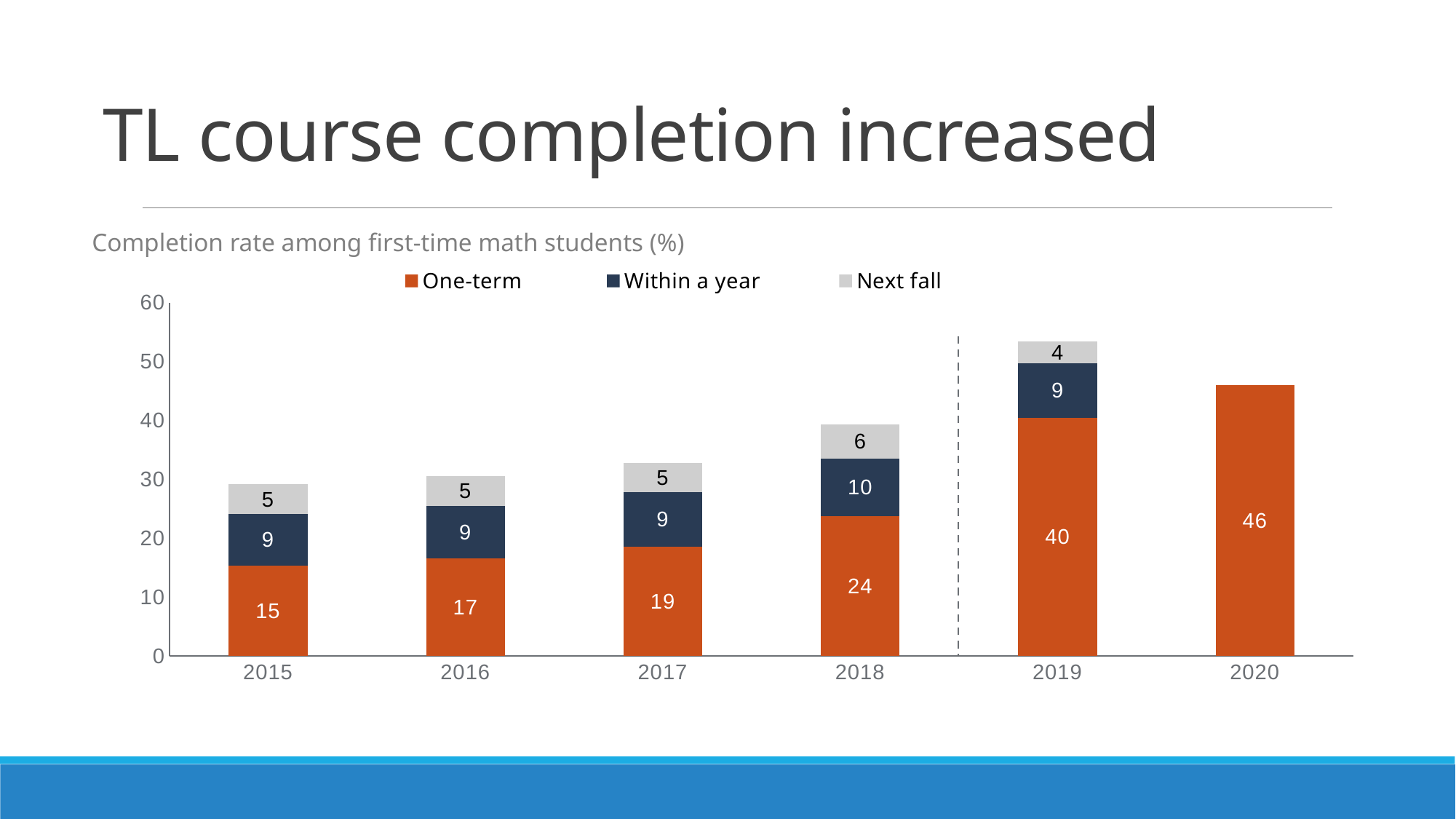
Which year has the highest One-term completion rate? 2020 Does the One-term completion rate rise or fall from 2015 to 2020? rise What is the One-term value for 2020? 46 What is the total of the stacked bar for 2019? 53 Which is larger, the One-term value for 2017 or for 2016? 2017 Which year has the lowest One-term completion rate? 2015 What is the Next fall value for 2019? 4 What is the total of the stacked bar for 2018? 40 How many series does the legend list? 3 What is the One-term completion rate for 2015? 15 What is the difference between the One-term values for 2019 and 2018? 16 What is the Within a year value for 2018? 10